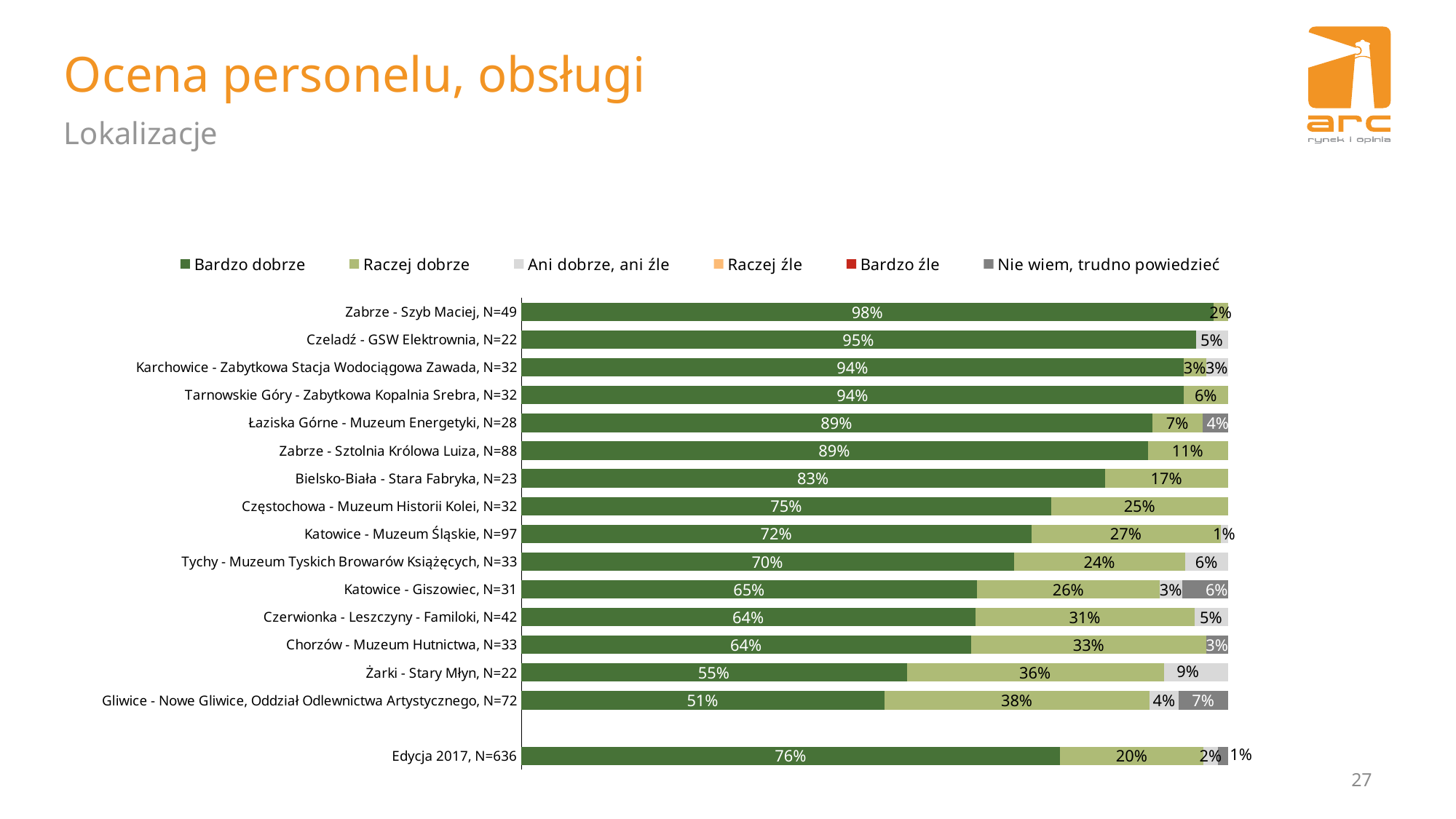
What is the 'Bardzo dobrze' value for Edycja 2017, N=636? 76% How many series does the legend list? 6 What is the difference between the 'Bardzo dobrze' values for Zabrze - Szyb Maciej, N=49 and Żarki - Stary Młyn, N=22? 43% What is the 'Raczej dobrze' value for Gliwice - Nowe Gliwice, Oddział Odlewnictwa Artystycznego, N=72? 38% Which location has the highest 'Bardzo dobrze' value? Zabrze - Szyb Maciej, N=49 What is the 'Bardzo dobrze' value for Zabrze - Szyb Maciej, N=49? 98% What is the title of the slide? Ocena personelu, obsługi Which location has the lowest 'Bardzo dobrze' value? Gliwice - Nowe Gliwice, Oddział Odlewnictwa Artystycznego, N=72 Which has a larger 'Raczej dobrze' value: Chorzów - Muzeum Hutnictwa, N=33 or Tychy - Muzeum Tyskich Browarów Książęcych, N=33? Chorzów - Muzeum Hutnictwa, N=33 What kind of chart is shown on the slide? Stacked bar chart What is the 'Nie wiem, trudno powiedzieć' value for Katowice - Giszowiec, N=31? 6% How many bars are plotted in the chart, including Edycja 2017? 16